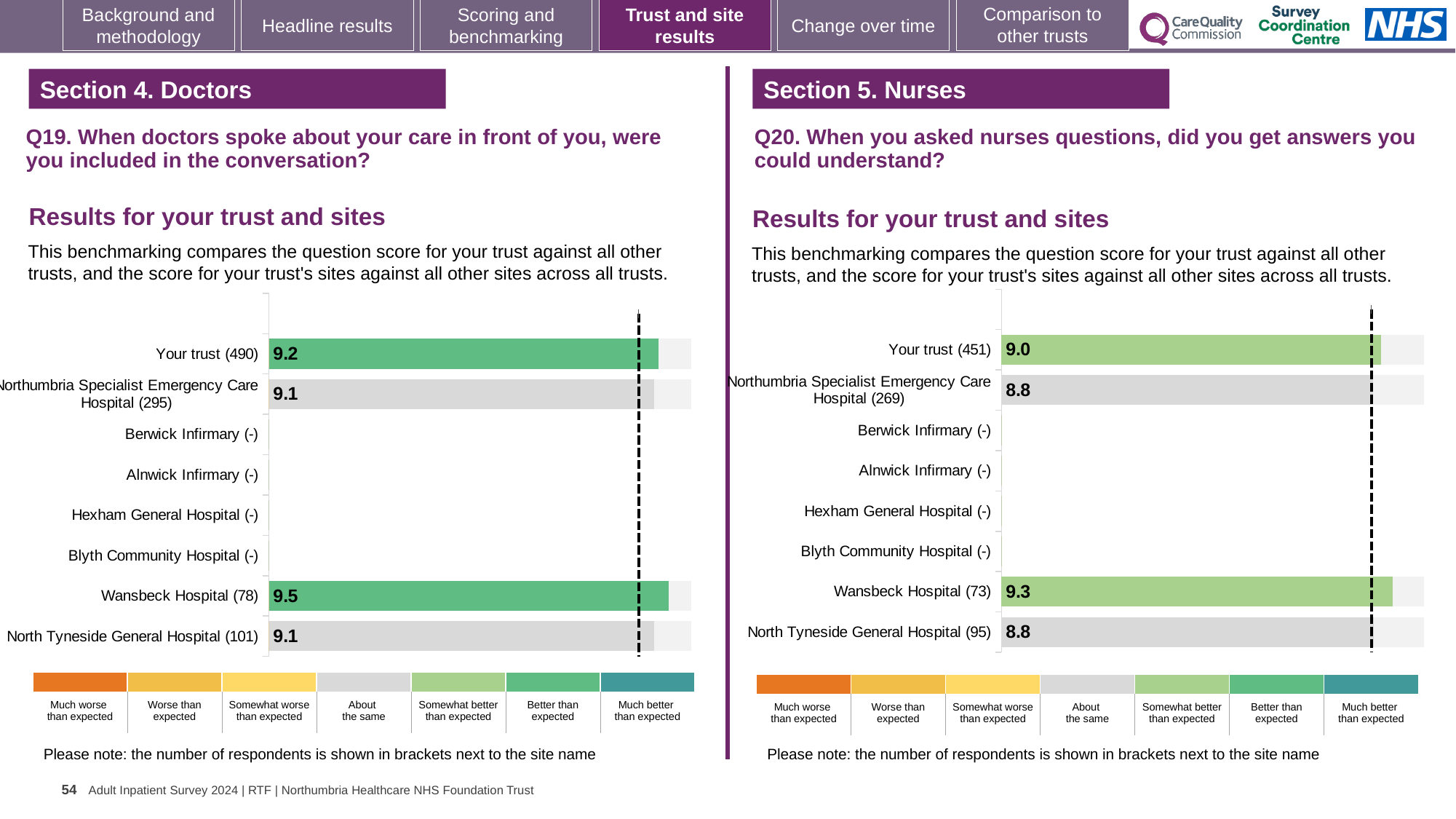
On the Q19 chart (left), how many respondents are shown in brackets for Your trust? 490 On the Q19 chart (left), what is the difference between the Wansbeck Hospital score and the Your trust score? 0.3 On the Q20 chart (right), what is the score for North Tyneside General Hospital? 8.8 On the Q19 chart (left), which site with a plotted score has the highest value? Wansbeck Hospital On the Q20 chart (right), which site with a plotted score has the highest value? Wansbeck Hospital On the Q20 chart (right), what is the difference between the Wansbeck Hospital score and the Northumbria Specialist Emergency Care Hospital score? 0.5 On the Q20 chart (right), what is the score for Your trust? 9.0 Which is larger: the Your trust score on the Q19 chart or the Your trust score on the Q20 chart? Q19 (9.2) How many site categories (including Your trust) are listed on the Q20 chart (right)? 8 On the Q19 chart (left), what is the score for Wansbeck Hospital? 9.5 On the Q19 chart (left), what is the score for Your trust? 9.2 What kind of chart is used on the Q19 chart (left)? Bar chart